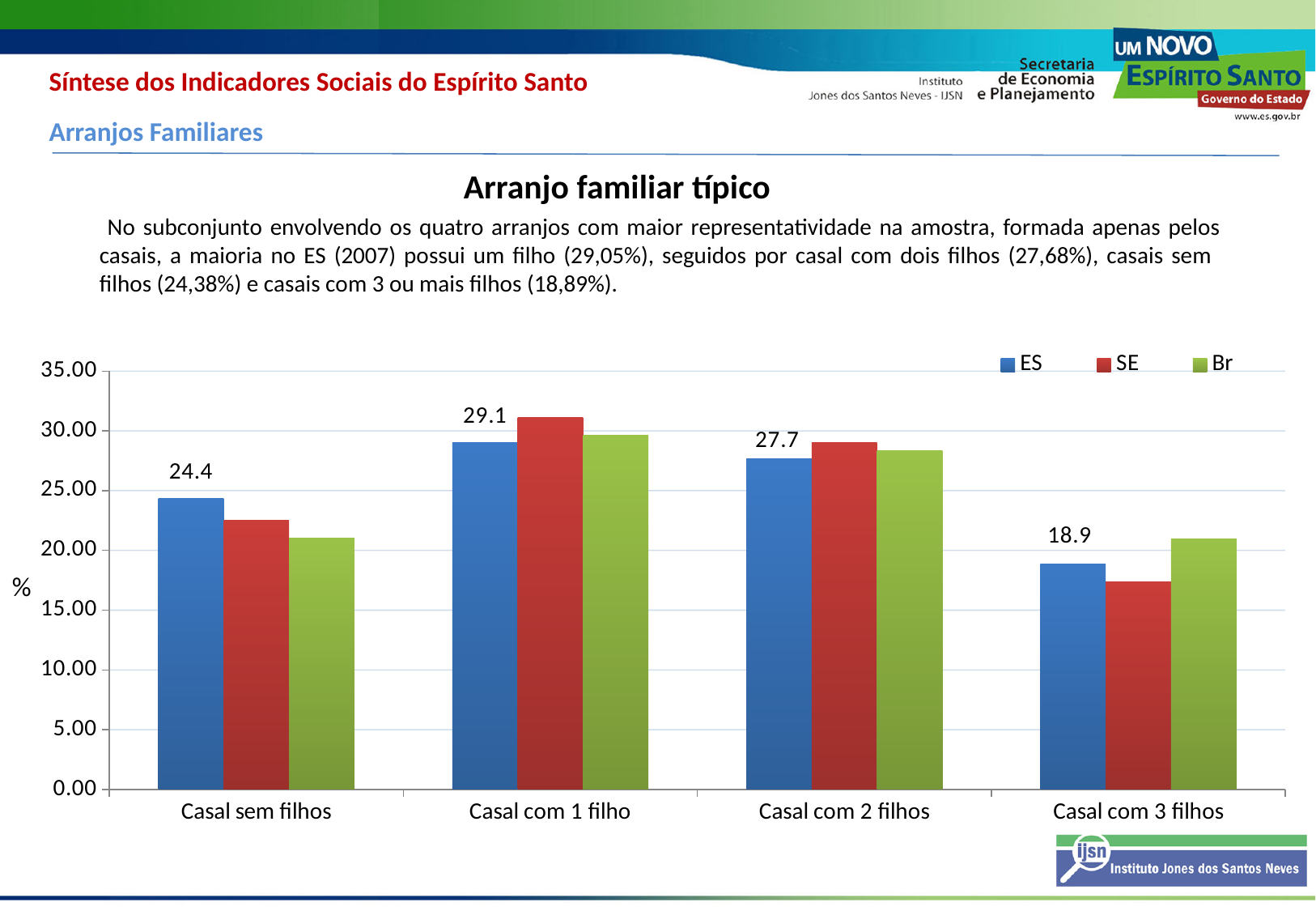
What is the difference between the ES values for Casal com 1 filho and Casal com 3 filhos? 10.2 In the Casal com 1 filho category, which series has the larger value, ES or SE? SE What is the value for ES in the Casal com 3 filhos category? 18.9 Which category has the highest value for the ES series? Casal com 1 filho What is the value for ES in the Casal sem filhos category? 24.4 Is the value for SE in the Casal com 3 filhos category greater or less than 20.00? less What is the value for ES in the Casal com 1 filho category? 29.1 Which category has the lowest value for the ES series? Casal com 3 filhos How many categories are shown on the x axis? 4 What kind of chart is shown on the slide? bar chart In the Casal sem filhos category, which series has the larger value, ES or SE? ES How many series does the legend list? 3